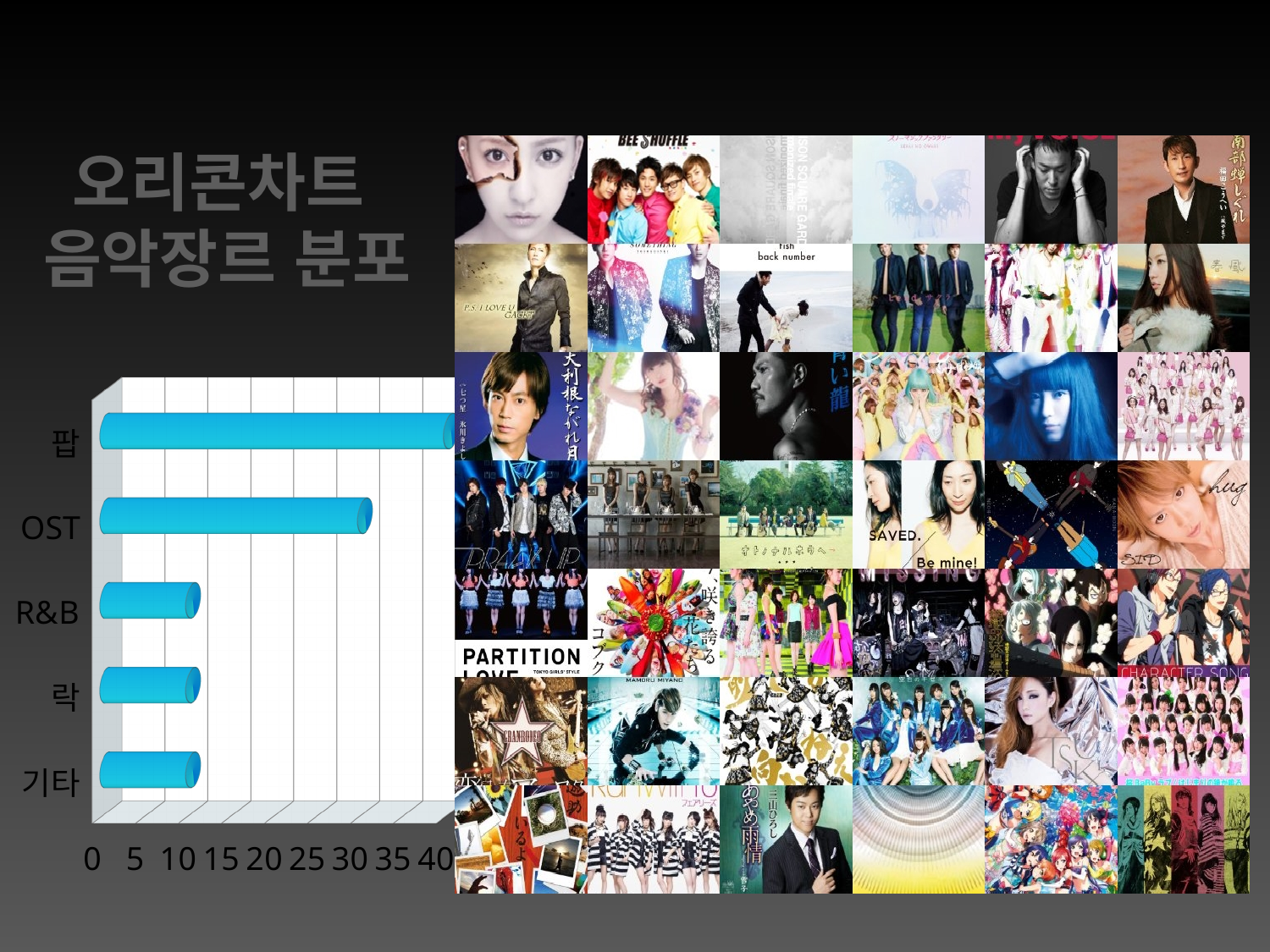
What kind of chart is shown on the slide? bar chart What is the title shown on the slide for the chart? 오리콘차트 음악장르 분포 What is the highest value shown on the chart's axis? 40 Which is larger, the value for OST or the value for R&B? OST Is the value for 락 greater or less than 5? greater Which is larger, the value for 팝 or the value for OST? 팝 Is the value for R&B greater or less than 15? less How many categories does the bar chart show? 5 Which category has the highest value in the bar chart? 팝 Is the value for OST greater or less than 25? greater